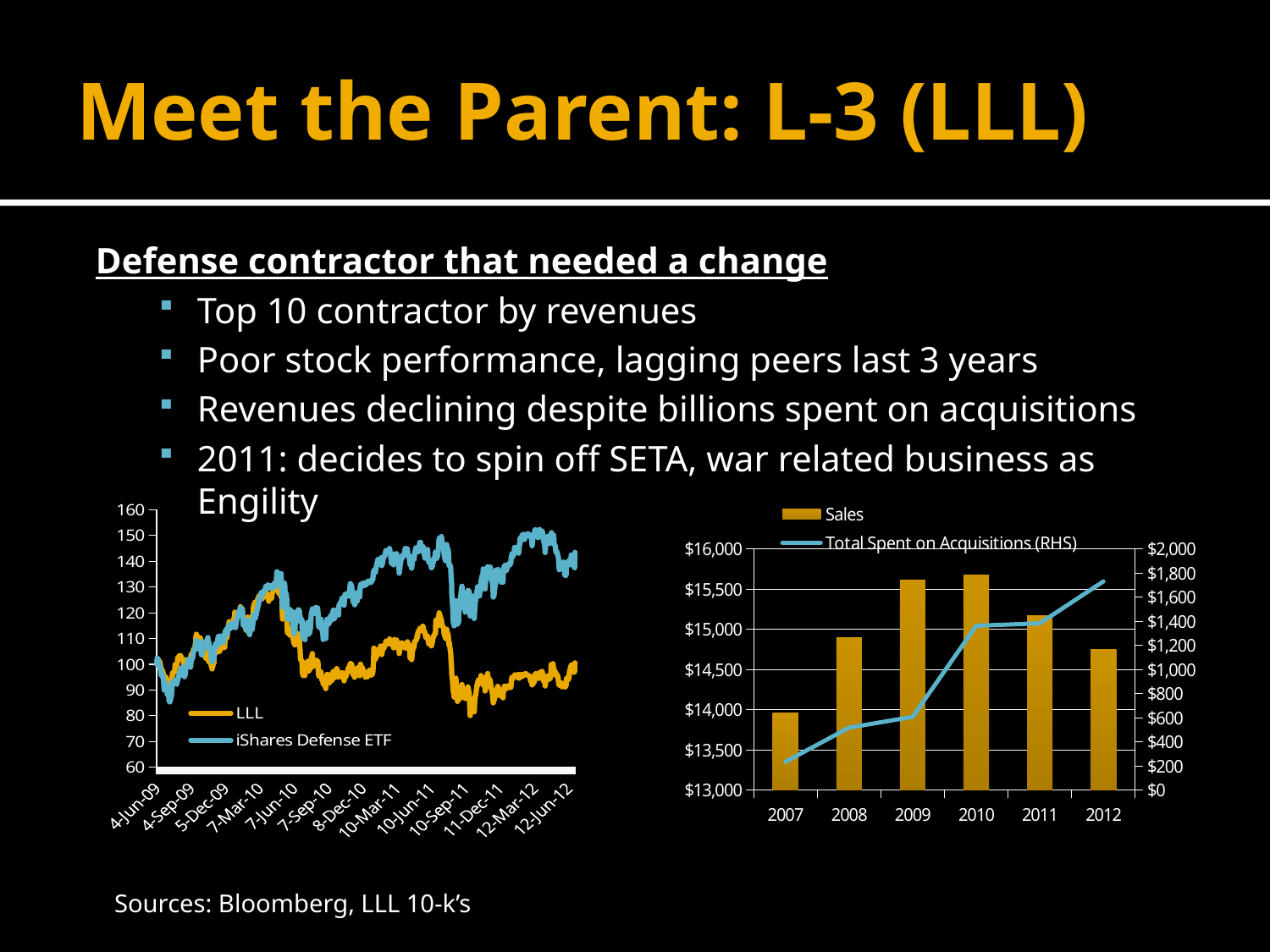
In the right chart, is the Sales value for 2009 greater or less than $15,500? greater How many series does the legend of the right chart list? 2 What kind of chart is the chart on the left of the slide? line chart In the right chart, which year has the lowest Sales bar? 2007 How many series does the legend of the left chart list? 2 In the right chart, does the Total Spent on Acquisitions (RHS) line generally rise or fall from 2007 to 2012? rise In the right chart, how many years are shown on the x axis? 6 What kind of chart is the chart on the right of the slide? bar chart combined with a line In the left chart, which series is higher at the end of the period (12-Jun-12), LLL or iShares Defense ETF? iShares Defense ETF In the right chart, is the Sales value for 2012 greater or less than $15,000? less In the right chart, which year has the larger Sales bar, 2008 or 2011? 2011